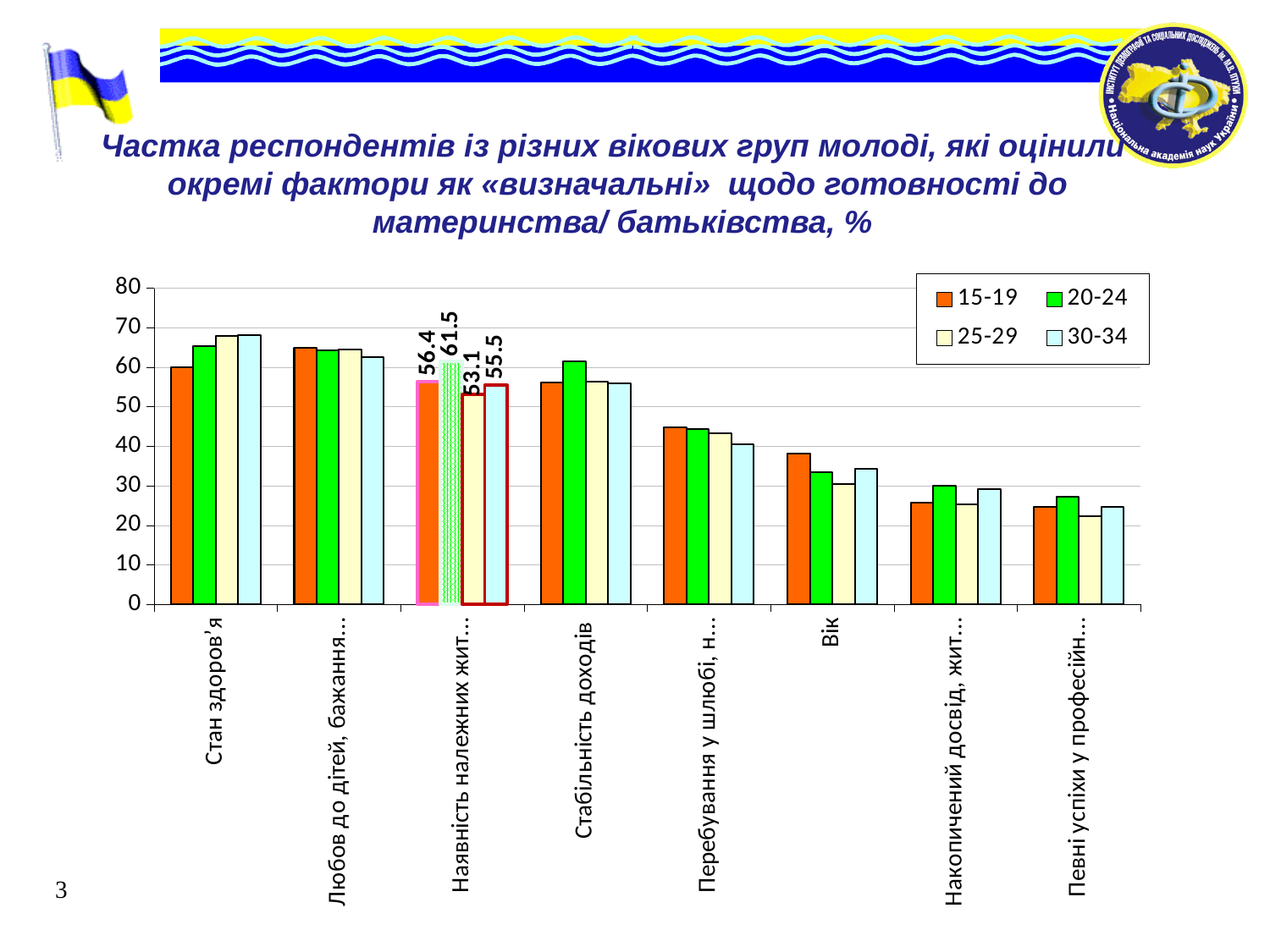
What kind of chart is shown on the slide? bar chart Is the value for the 15-19 age group in the category "Вік" greater or less than 30? greater What is the value for the 15-19 age group in the category "Наявність належних жит..."? 56.4 What is the value for the 25-29 age group in the category "Наявність належних жит..."? 53.1 What is the value for the 20-24 age group in the category "Наявність належних жит..."? 61.5 In the category "Наявність належних жит...", which age group has the highest value? 20-24 How many categories are shown along the x axis? 8 In the category "Наявність належних жит...", what is the difference between the 20-24 and 25-29 values? 8.4 How many series does the legend list? 4 In the category "Стан здоров'я", which is larger: the value for 15-19 or the value for 30-34? 30-34 In the category "Наявність належних жит...", which age group has the lowest value? 25-29 What is the value for the 30-34 age group in the category "Наявність належних жит..."? 55.5